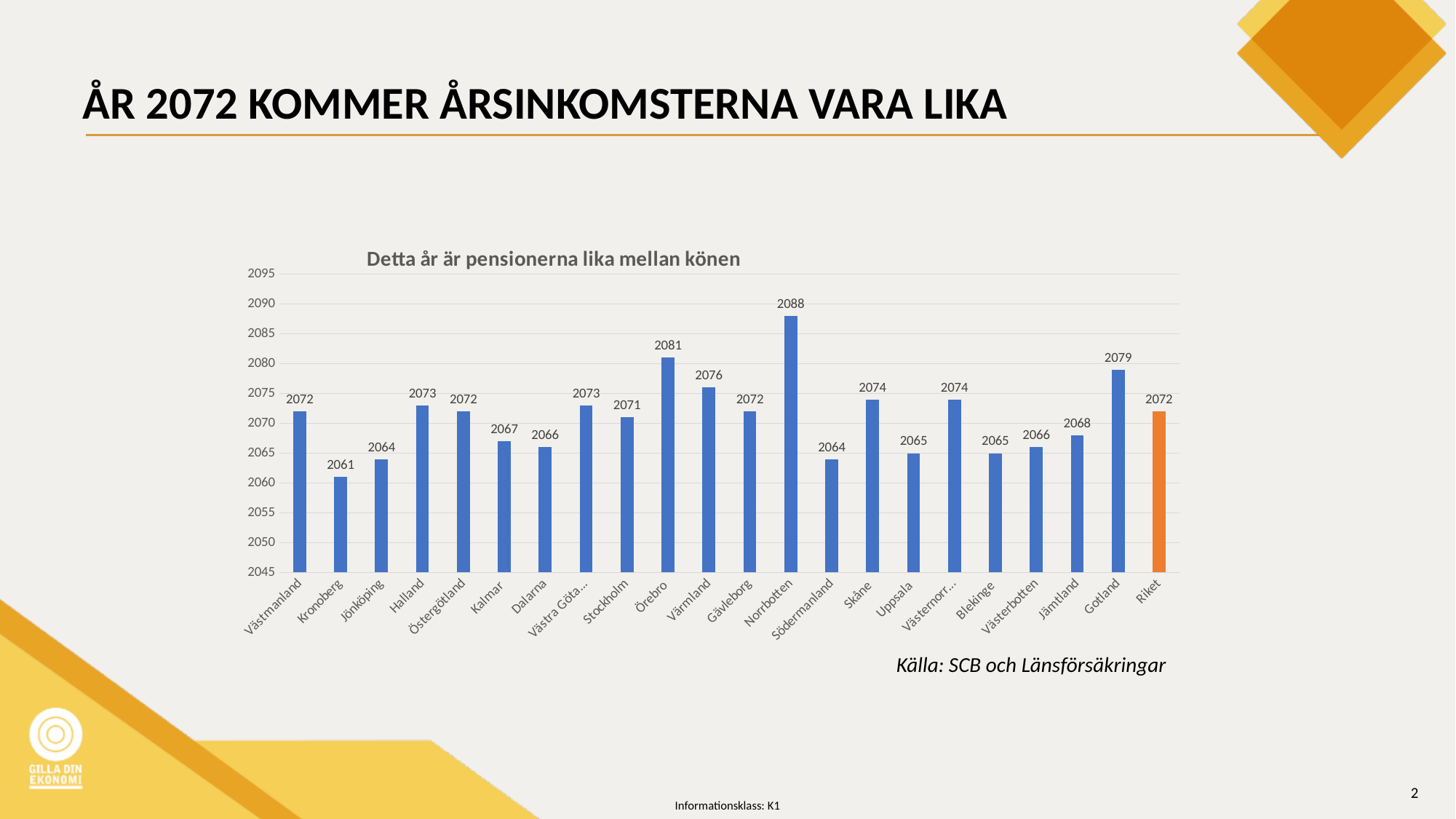
What kind of chart is shown on the slide? Bar chart What is the value for Norrbotten? 2088 What is the value for Kronoberg? 2061 Which category has the highest value? Norrbotten Which category has the lowest value? Kronoberg What is the value for Riket? 2072 What is the difference between the values for Örebro and Stockholm? 10 What is the difference between the values for Norrbotten and Kronoberg? 27 How many bars are shown in the chart? 22 What is the value for Gotland? 2079 Which bar is shown in orange rather than blue? Riket Which is larger, the value for Värmland or the value for Jämtland? Värmland